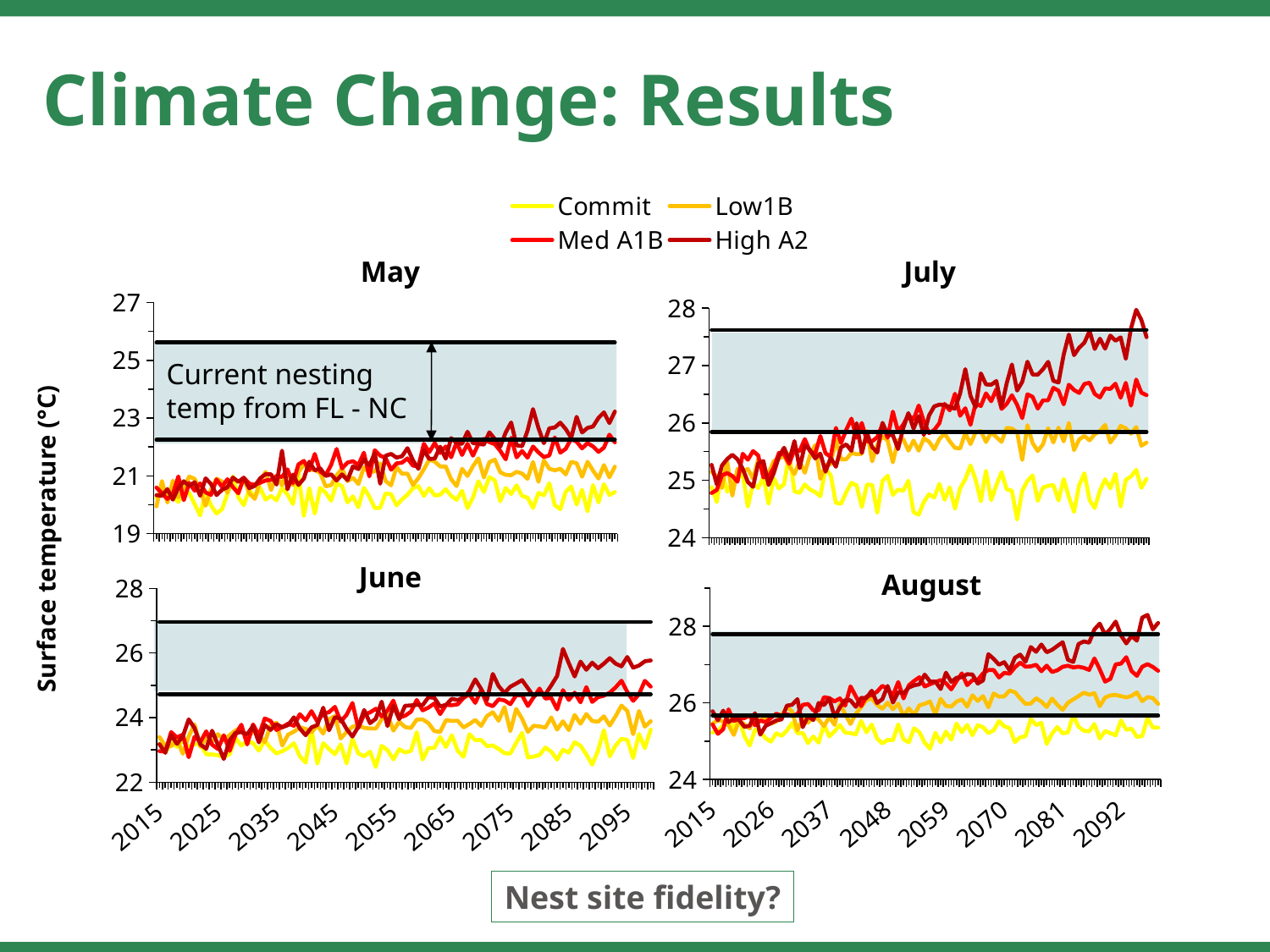
What does the shaded band in the May chart represent, according to its label? Current nesting temp from FL - NC In the July chart, which is larger at the end of the x axis, High A2 or Commit? High A2 In the May chart, is the High A2 value at the end of the x axis greater or less than 25? less In the August chart, is the High A2 value at the end of the x axis greater or less than 27? greater In the August chart, which series is highest at the end of the x axis? High A2 In the July chart, which series is lowest at the end of the x axis? Commit In the June chart, is the Commit value at the end of the x axis greater or less than 25? less How many series does the legend list? 4 How many charts are shown on the slide? 4 In the July chart, does the High A2 series rise or fall from 2015 to the end of the x axis? rise What kind of chart is the May chart? line chart